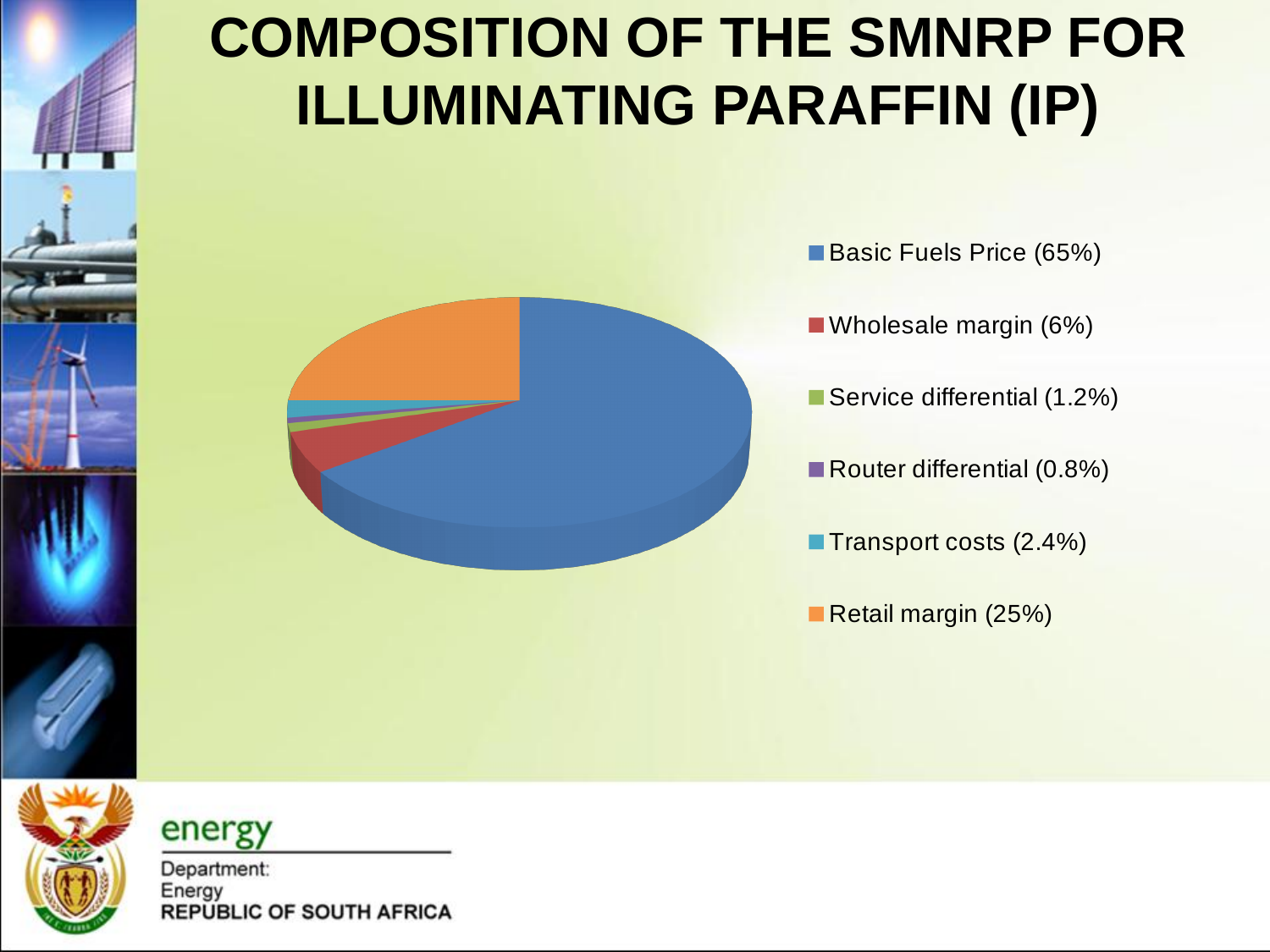
What is the share for Transport costs? 2.4% What percentage is shown for the Router differential? 0.8% What kind of chart is shown on the slide? Pie chart Which component has the largest share of the pie? Basic Fuels Price What percentage does the Retail margin make up? 25% What share of the SMNRP for illuminating paraffin is the Basic Fuels Price? 65% Which is larger, the Wholesale margin or the Transport costs? Wholesale margin What colour is the Retail margin slice in the pie chart? Orange How many slices does the pie chart have? 6 Which component has the smallest share of the pie? Router differential What is the difference in percentage points between the Basic Fuels Price and the Retail margin? 40 What is the combined share of the Service differential and the Router differential? 2%